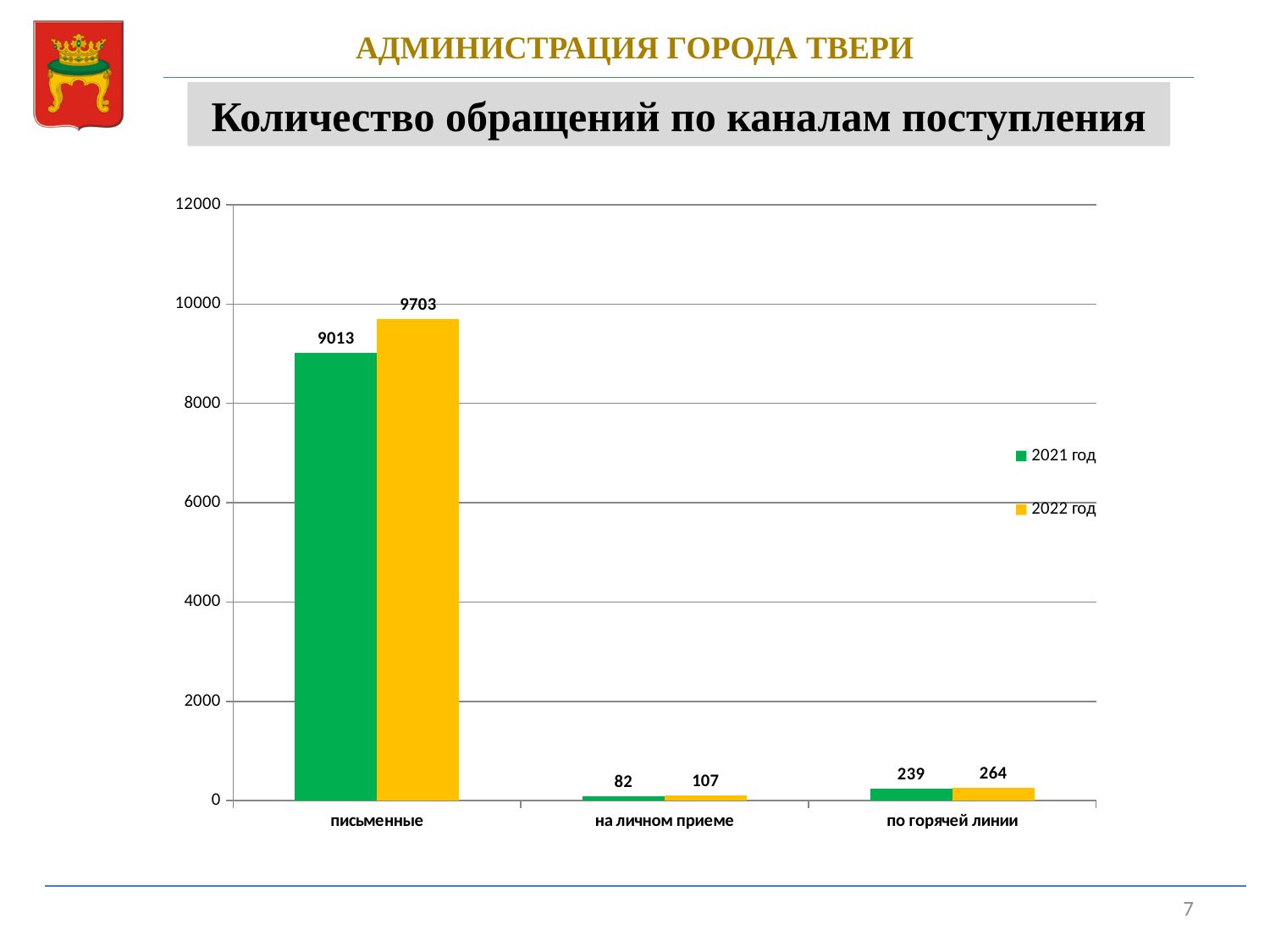
What is the value for письменные in 2021 год? 9013 What is the difference between the 2022 год and 2021 год values for письменные? 690 What is the value for по горячей линии in 2022 год? 264 Which category has the highest value in 2022 год? письменные How many series does the legend list? 2 Which category has the lowest value in 2021 год? на личном приеме How many categories are shown on the x axis? 3 What is the value for письменные in 2022 год? 9703 What is the value for на личном приеме in 2021 год? 82 What kind of chart is shown on the slide? bar chart What is the difference between the 2022 год and 2021 год values for по горячей линии? 25 Which is larger for на личном приеме: the 2021 год value or the 2022 год value? 2022 год